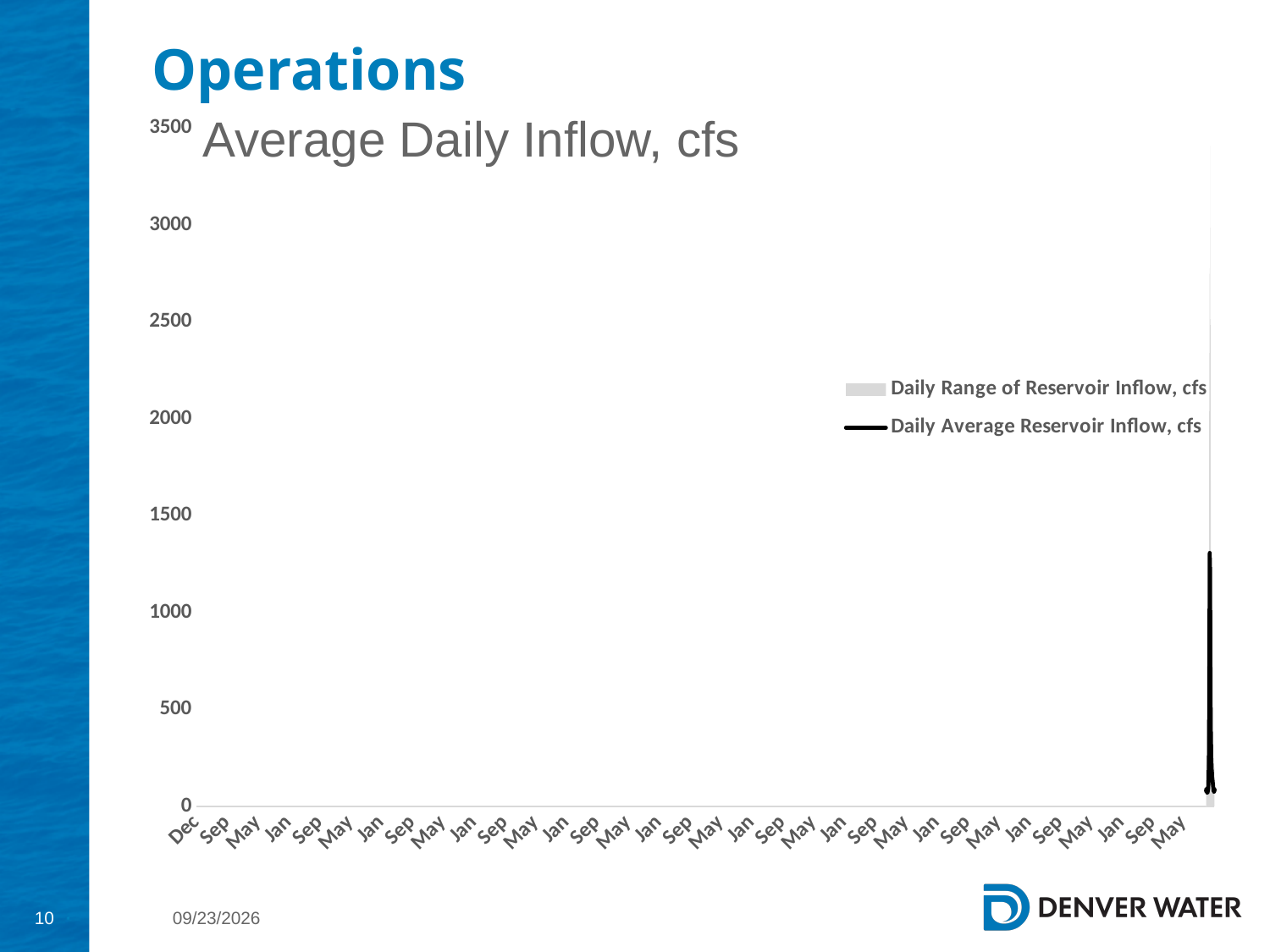
Does the Daily Average Reservoir Inflow line stay near zero for most of the x axis before spiking at the far right? yes Is the peak value of the Daily Average Reservoir Inflow line greater or less than 1500? less What kind of chart is the Average Daily Inflow chart? combination area and line chart Which legend entry is shown with a black line? Daily Average Reservoir Inflow, cfs Is the peak value of the Daily Average Reservoir Inflow line greater or less than 1000? greater Is the peak value of the Daily Average Reservoir Inflow line greater or less than 2000? less What is the title of the chart on the slide? Average Daily Inflow, cfs How many series does the legend list on the Average Daily Inflow chart? 2